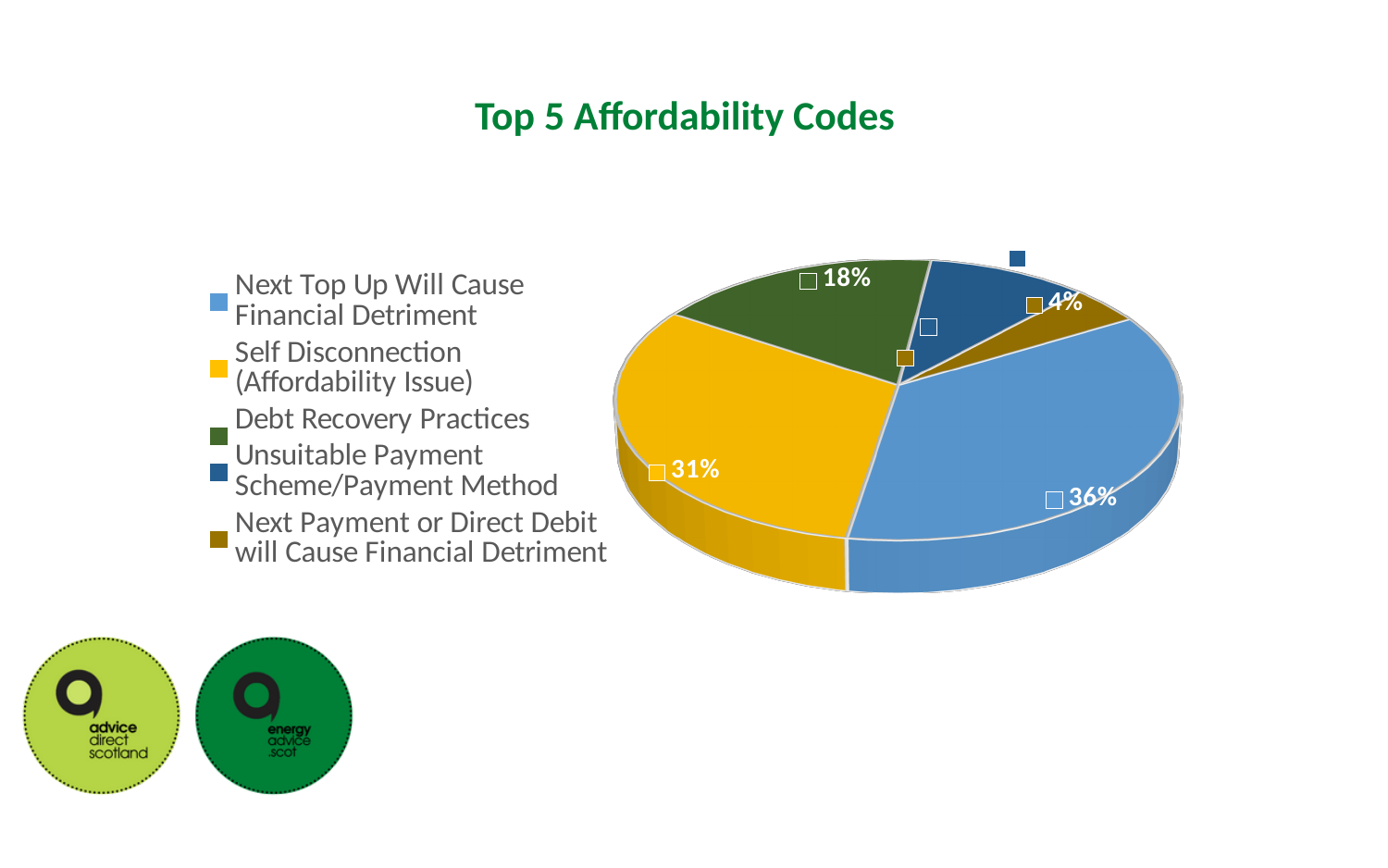
Which is larger: the share for Debt Recovery Practices or the share for Self Disconnection (Affordability Issue)? Self Disconnection (Affordability Issue) How many percentage points larger is the Next Top Up Will Cause Financial Detriment share than the Self Disconnection (Affordability Issue) share? 5 percentage points What percentage is shown for Debt Recovery Practices? 18% Which affordability code has the smallest share of the pie? Next Payment or Direct Debit will Cause Financial Detriment How many affordability codes are shown in the pie chart? 5 What percentage is shown for Self Disconnection (Affordability Issue)? 31% Which affordability code has the largest share of the pie? Next Top Up Will Cause Financial Detriment What share of the pie does Next Top Up Will Cause Financial Detriment represent? 36% What is the title of the chart? Top 5 Affordability Codes What type of chart is shown on the slide? Pie chart What percentage is shown for Next Payment or Direct Debit will Cause Financial Detriment? 4% What is the difference between the Self Disconnection (Affordability Issue) share and the Debt Recovery Practices share? 13 percentage points